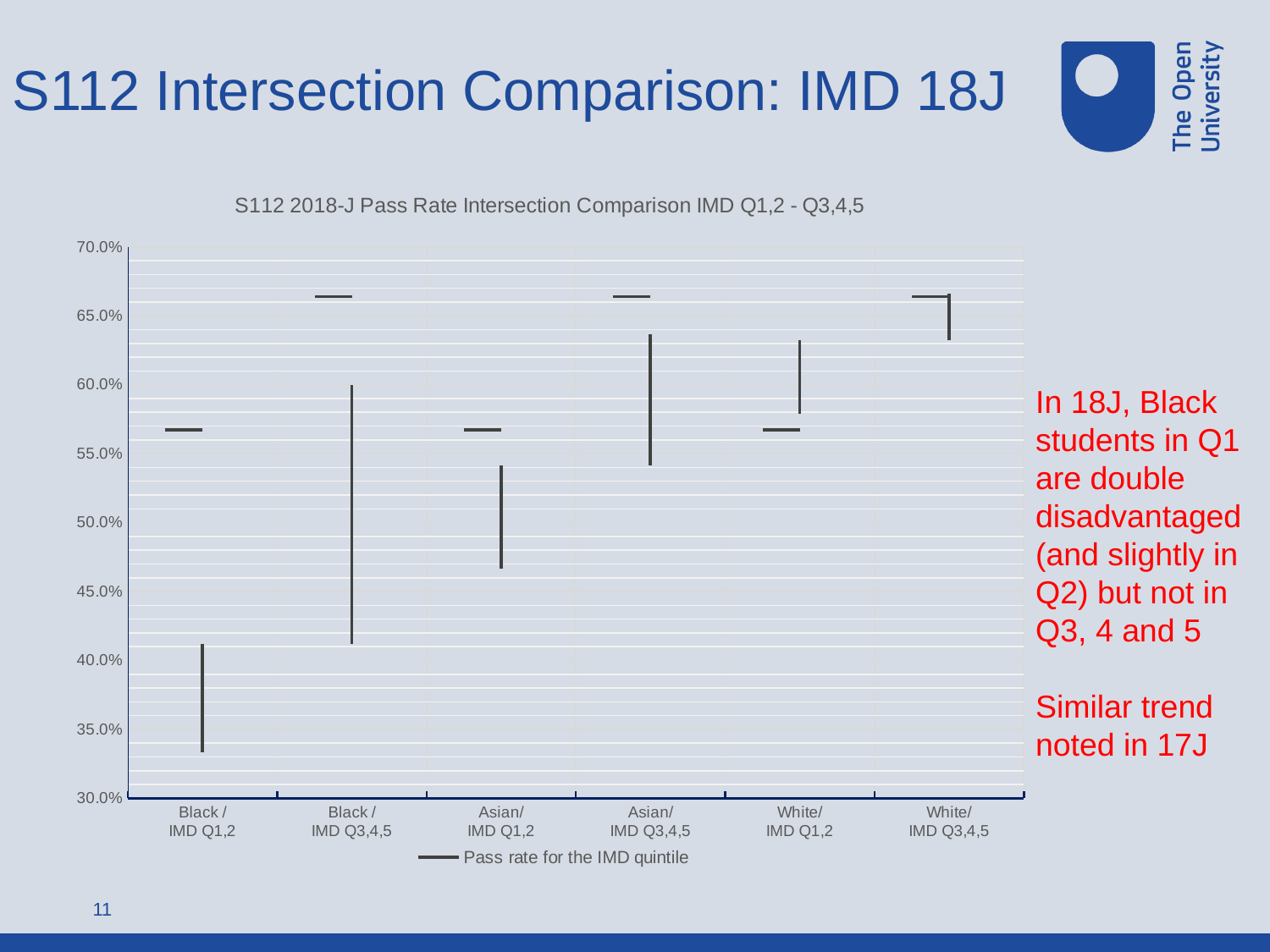
Is the pass rate marker for Black / IMD Q1,2 greater or less than 55.0%? greater What is the legend entry shown below the chart? Pass rate for the IMD quintile What is the lowest value shown on the y axis of the chart? 30.0% How many series does the chart legend list? 1 Is the top of the vertical range for Asian/ IMD Q1,2 greater or less than 55.0%? less What is the title of the chart? S112 2018-J Pass Rate Intersection Comparison IMD Q1,2 - Q3,4,5 Is the bottom of the vertical range for White/ IMD Q3,4,5 greater or less than 60.0%? greater How many categories are shown on the x axis of the chart? 6 Which has the higher vertical range: Black / IMD Q1,2 or White/ IMD Q1,2? White/ IMD Q1,2 Which category has the lowest vertical range on the chart? Black / IMD Q1,2